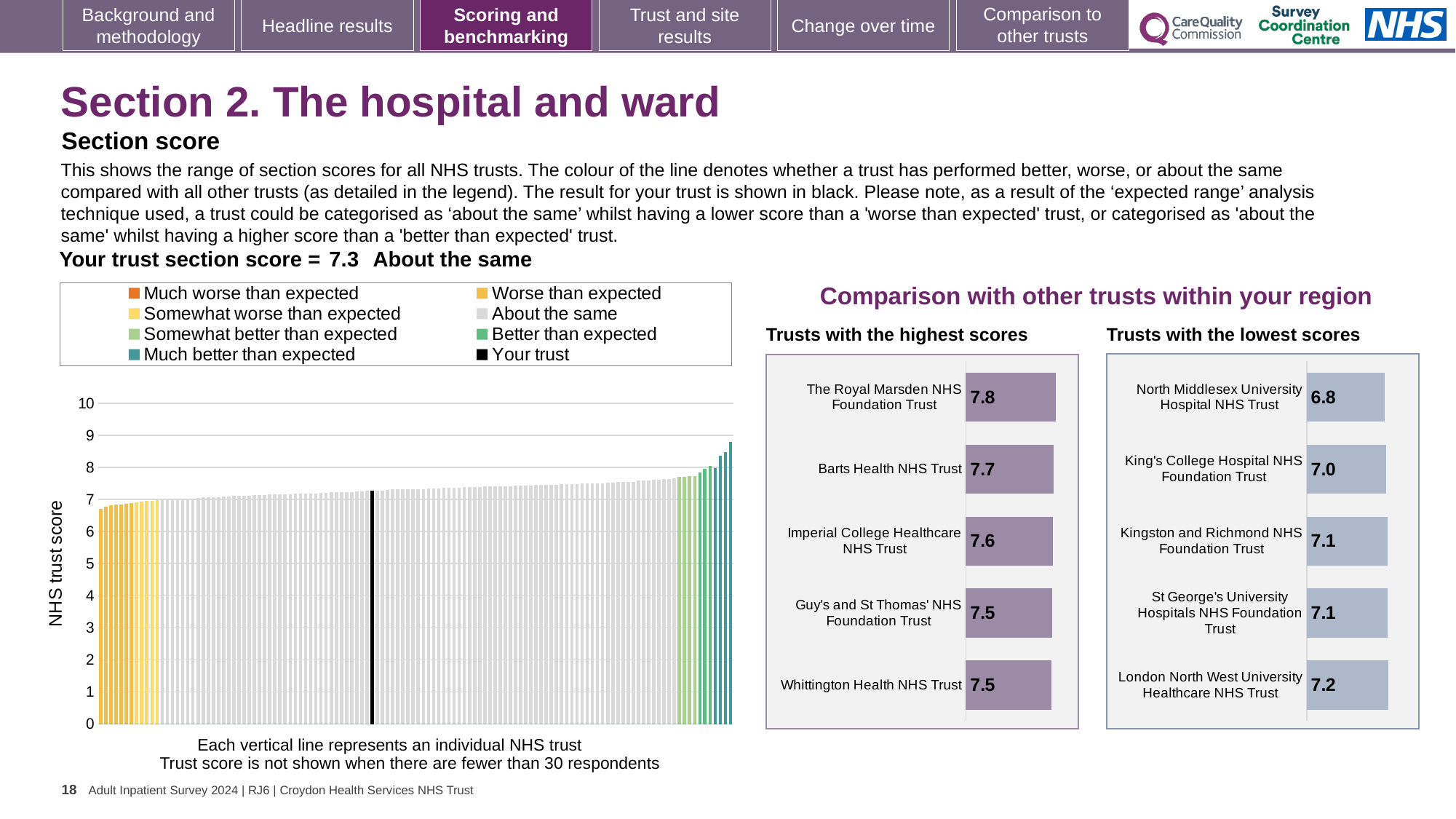
How many entries does the legend of the large chart on the left list? 8 In the large chart on the left, is the value of the tallest bar greater or less than 8? greater In the 'Trusts with the highest scores' chart, what is the difference between the scores of The Royal Marsden NHS Foundation Trust and Whittington Health NHS Trust? 0.3 How many trusts are shown in the 'Trusts with the lowest scores' chart? 5 In the 'Trusts with the highest scores' chart, which trust has the highest score? The Royal Marsden NHS Foundation Trust In the 'Trusts with the highest scores' chart, which has the larger score: Barts Health NHS Trust or Imperial College Healthcare NHS Trust? Barts Health NHS Trust In the 'Trusts with the highest scores' chart, what is the score for The Royal Marsden NHS Foundation Trust? 7.8 According to the slide, what is your trust's section score shown in black on the large chart on the left? 7.3 What kind of chart is the large chart on the left showing NHS trust scores? bar chart In the 'Trusts with the lowest scores' chart, what is the difference between the scores of London North West University Healthcare NHS Trust and North Middlesex University Hospital NHS Trust? 0.4 In the 'Trusts with the lowest scores' chart, which trust has the lowest score? North Middlesex University Hospital NHS Trust In the 'Trusts with the lowest scores' chart, what is the score for North Middlesex University Hospital NHS Trust? 6.8